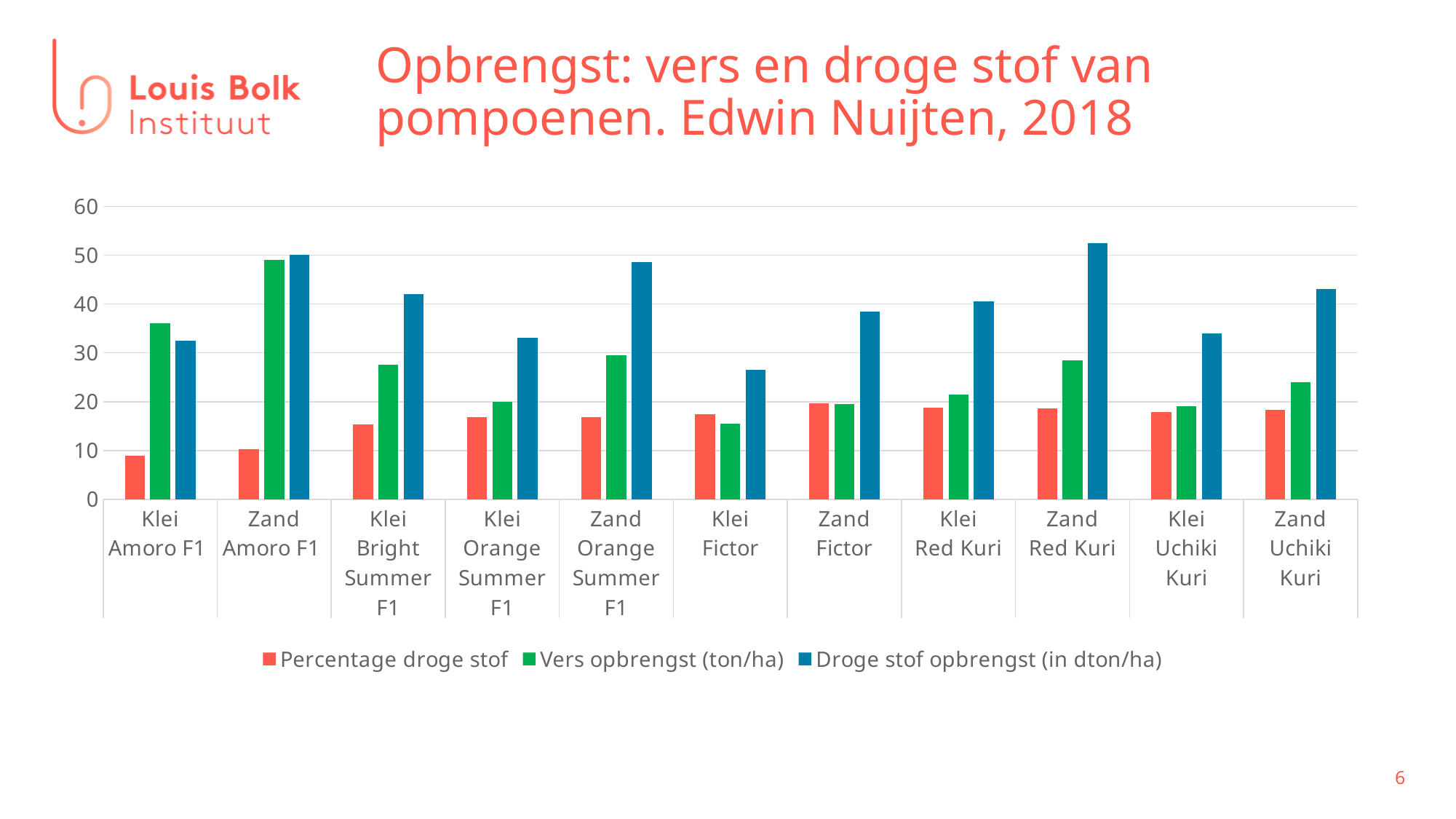
How many series does the legend list? 3 How many categories are shown on the x axis of the chart? 11 Which series is shown in green in the legend? Vers opbrengst (ton/ha) Is the Vers opbrengst (ton/ha) value for Zand Amoro F1 greater or less than 40? greater For Klei Amoro F1, which is larger: Vers opbrengst (ton/ha) or Droge stof opbrengst (in dton/ha)? Vers opbrengst (ton/ha) Which category has the lowest value for Percentage droge stof? Klei Amoro F1 Which category has the highest value for Vers opbrengst (ton/ha)? Zand Amoro F1 Is the Droge stof opbrengst (in dton/ha) value for Klei Fictor greater or less than 20? greater What kind of chart is shown on the slide? bar chart Which category has the highest value for Droge stof opbrengst (in dton/ha)? Zand Red Kuri Which category has the lowest value for Droge stof opbrengst (in dton/ha)? Klei Fictor Is the Vers opbrengst (ton/ha) value for Klei Bright Summer F1 greater or less than 30? less